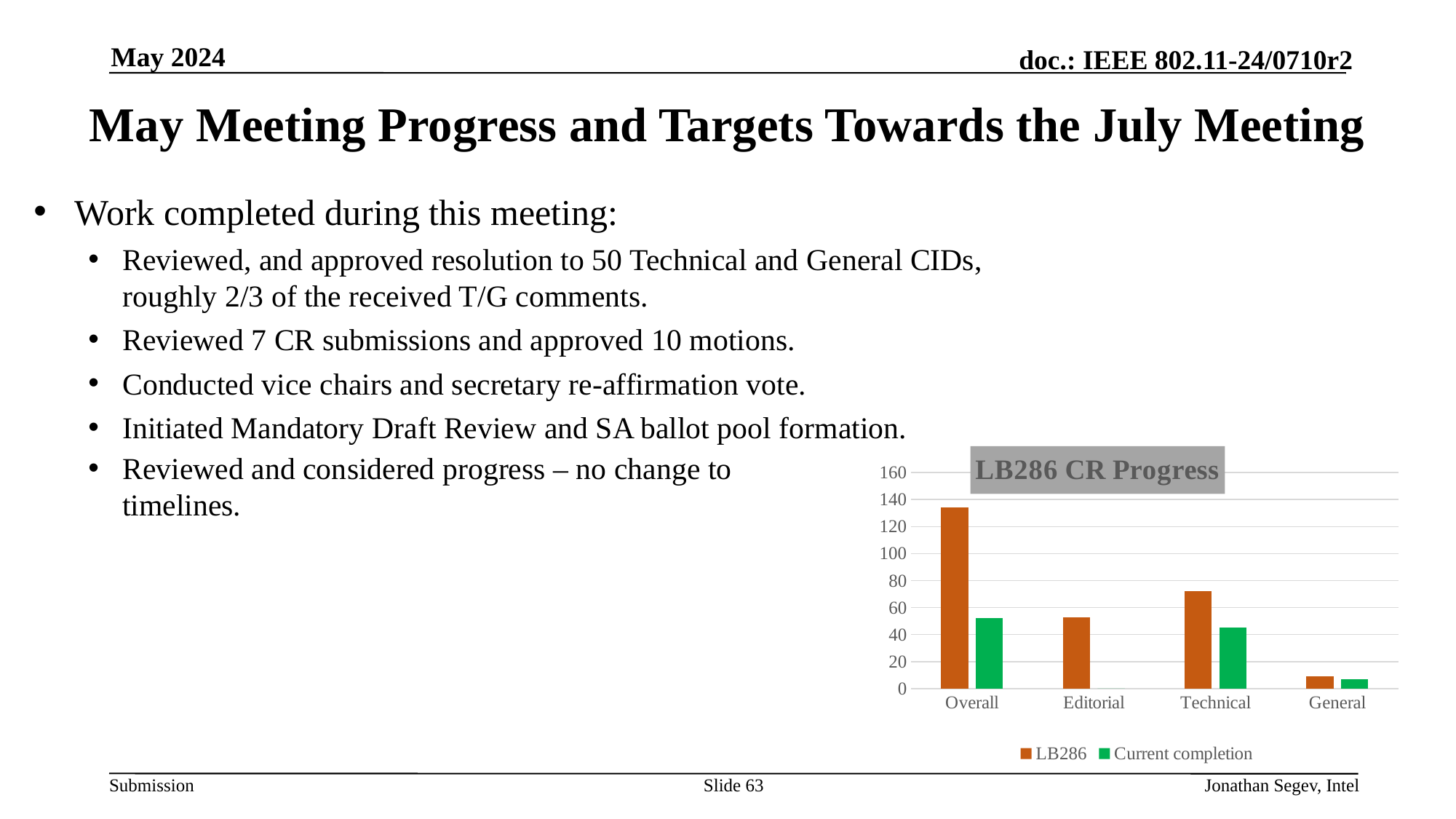
Which series is shown in green in the chart's legend? Current completion What is the title of the chart on the slide? LB286 CR Progress Which category has the lowest LB286 value? General Is the LB286 value for Editorial greater or less than 60? less Is the Current completion value for Overall greater or less than 40? greater Which category has the highest LB286 value? Overall Which is larger, the LB286 value for Technical or the LB286 value for Editorial? Technical Is the LB286 value for Overall greater or less than 120? greater How many categories are shown on the x axis of the chart? 4 How many series does the chart's legend list? 2 What kind of chart is shown on the slide? bar chart